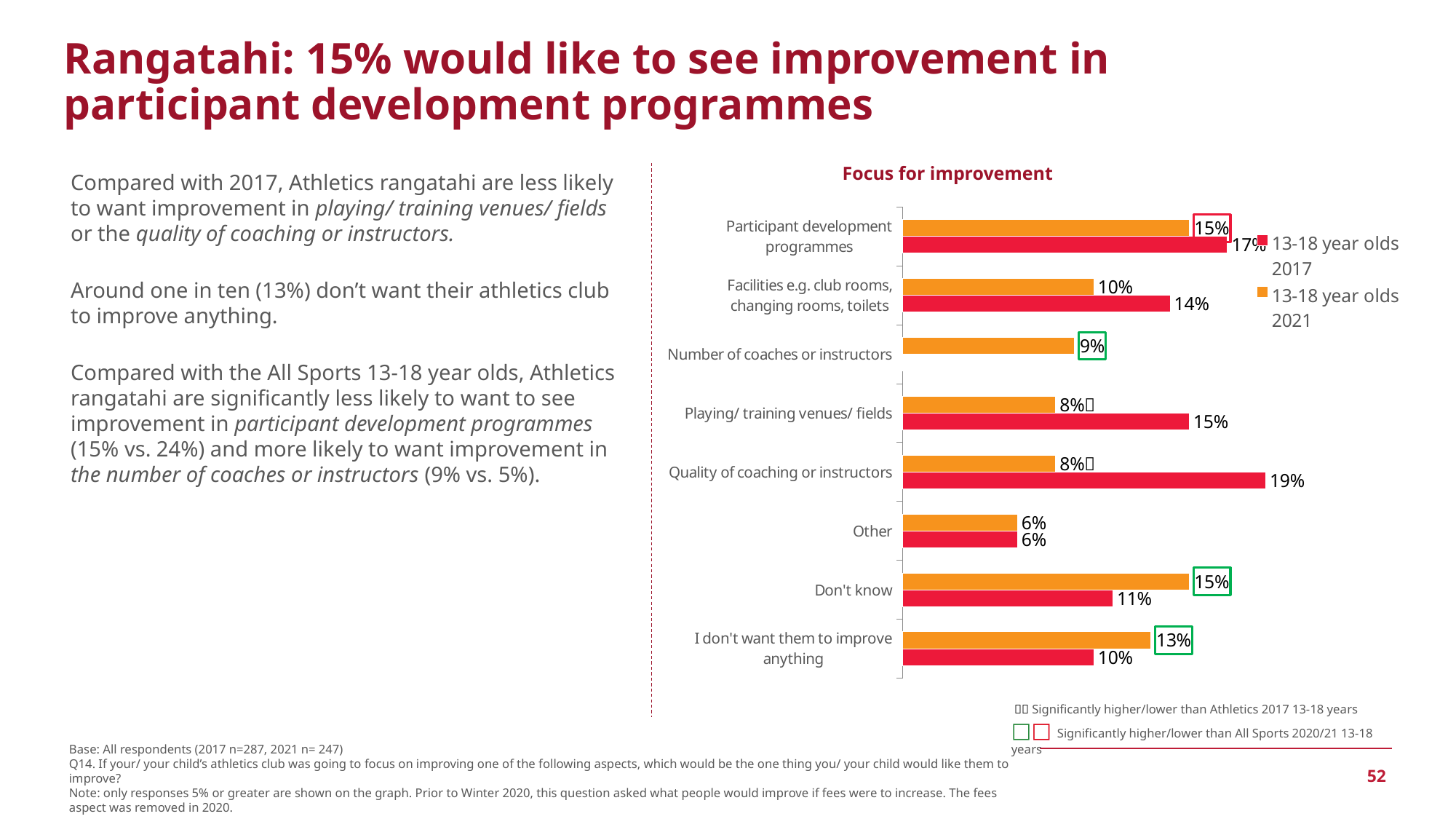
What type of chart is shown under the title 'Focus for improvement'? bar chart Which colour represents the 13-18 year olds 2021 series in the chart? orange What is the value for 'I don't want them to improve anything' for 13-18 year olds 2017? 10% Which category has the lowest value for 13-18 year olds 2021? Other What is the value for 'Quality of coaching or instructors' for 13-18 year olds 2017? 19% How many categories are shown on the 'Focus for improvement' chart? 8 What is the value for 'Number of coaches or instructors' for 13-18 year olds 2021? 9% What is the value for 'Participant development programmes' for 13-18 year olds 2021? 15% What is the difference between the 2017 and 2021 values for 'Playing/ training venues/ fields'? 7% How many series does the legend of the 'Focus for improvement' chart list? 2 For 'Don't know', which series has the larger value, 13-18 year olds 2017 or 13-18 year olds 2021? 13-18 year olds 2021 Which category has the highest value for 13-18 year olds 2017? Quality of coaching or instructors